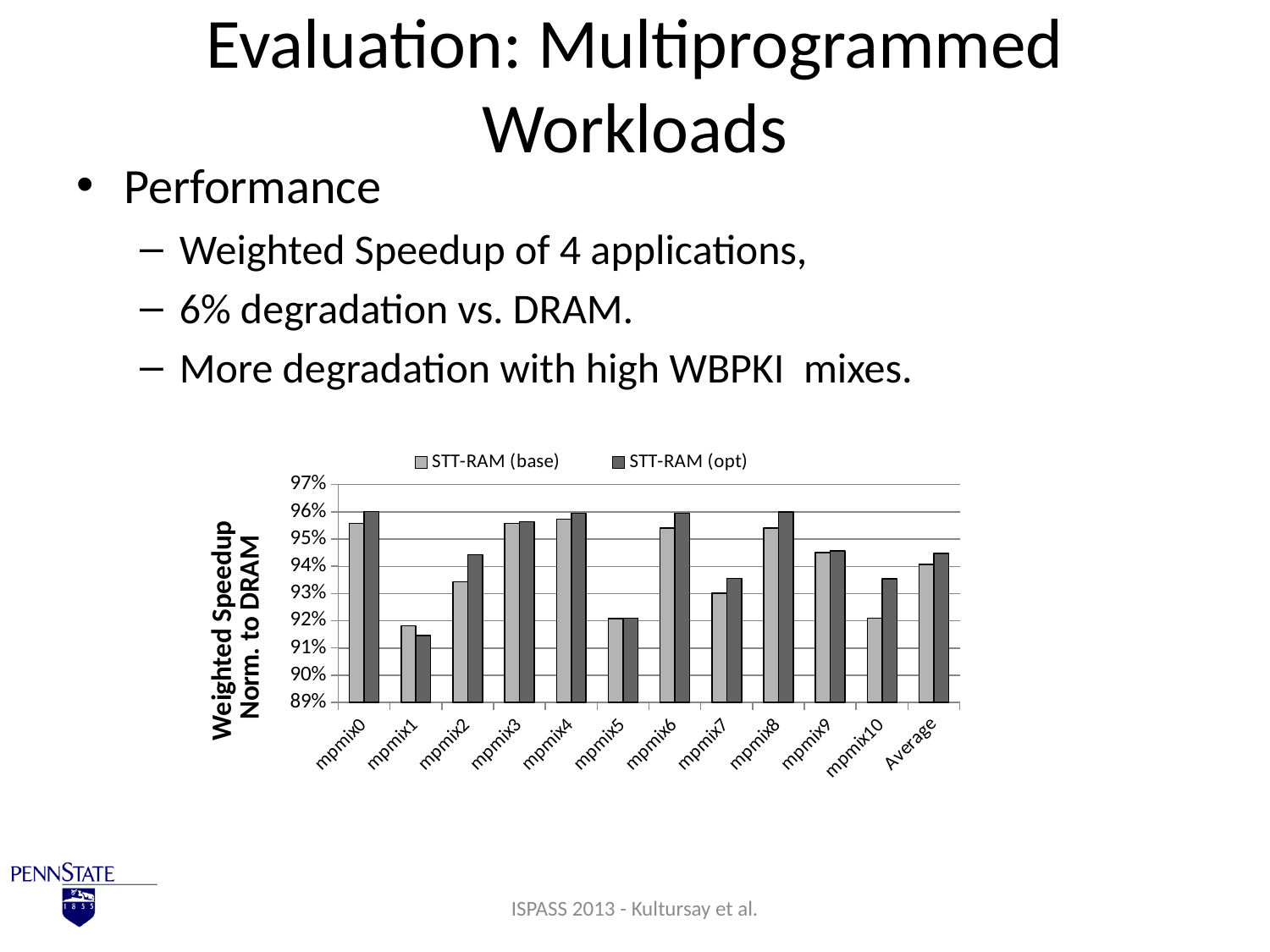
Is the STT-RAM (opt) value for mpmix2 greater or less than 94%? greater How many categories are shown along the x axis of the chart? 12 What is the label of the vertical axis of the chart? Weighted Speedup Norm. to DRAM What kind of chart is shown on the slide? bar chart Which category has the lowest STT-RAM (opt) value? mpmix1 Is the STT-RAM (opt) value for Average greater or less than 94%? greater How many series does the legend list? 2 Is the STT-RAM (base) value for mpmix10 greater or less than 93%? less For mpmix2, which is larger: STT-RAM (base) or STT-RAM (opt)? STT-RAM (opt) What are the two series named in the chart legend? STT-RAM (base) and STT-RAM (opt) For mpmix10, which is larger: STT-RAM (base) or STT-RAM (opt)? STT-RAM (opt)